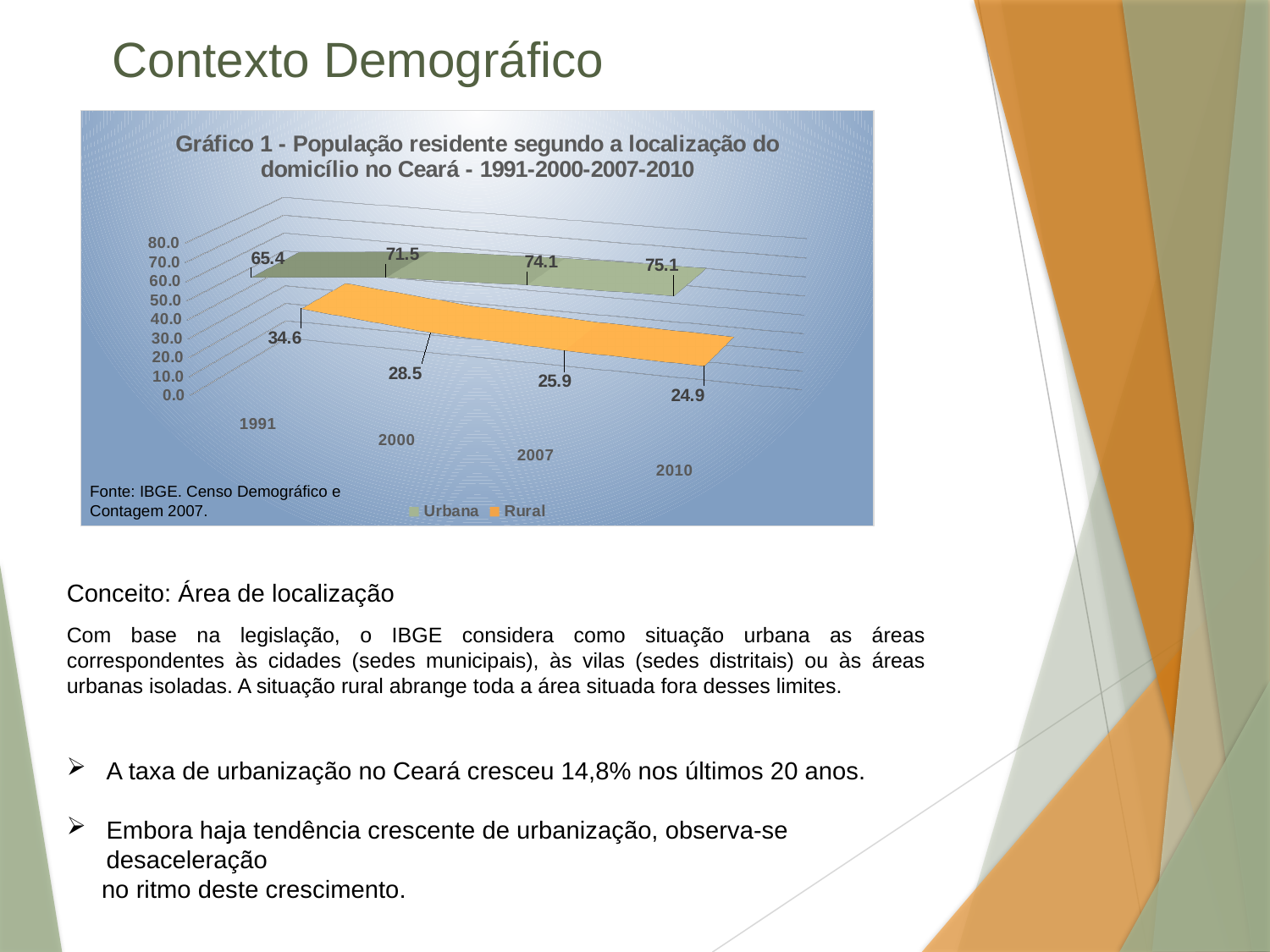
What kind of chart is shown on the slide? 3D line chart What is the value for Urbana in 2010? 75.1 What is the value for Rural in 1991? 34.6 Which is larger in 2000, the Urbana value or the Rural value? Urbana Does the Rural value rise or fall from 1991 to 2010? Fall In which year is the Rural value lowest? 2010 What is the value for Urbana in 2000? 71.5 What is the value for Rural in 2007? 25.9 In which year is the Urbana value highest? 2010 How many years are shown on the x axis? 4 How many series does the legend list? 2 What is the difference between the Urbana values in 2010 and 1991? 9.7